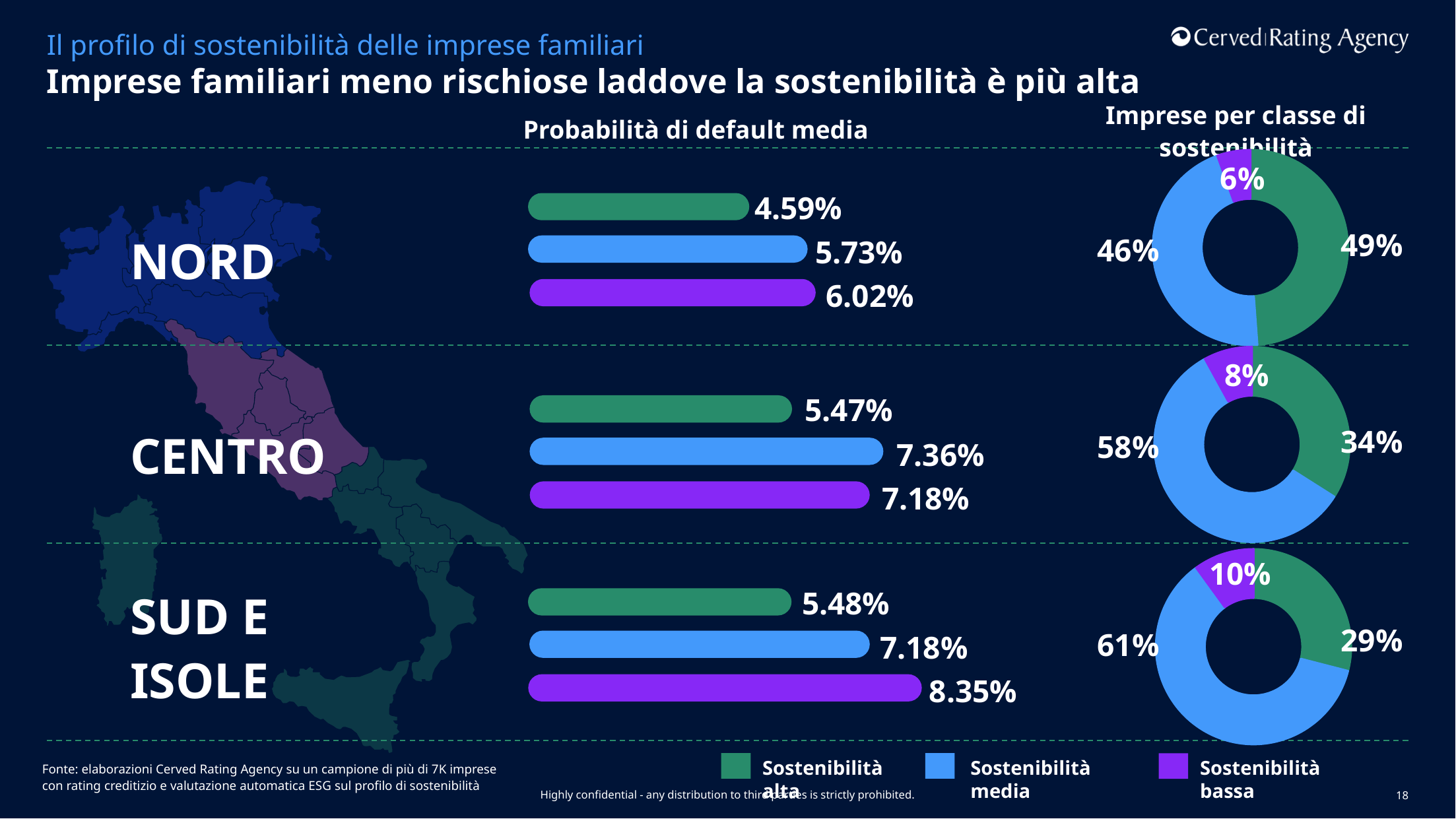
What kind of chart is used for 'Imprese per classe di sostenibilità'? Donut (pie) chart In the 'Probabilità di default media' bar chart, which sustainability class has the highest value in the SUD E ISOLE region? Sostenibilità bassa In the 'Probabilità di default media' bar chart, what is the value for Sostenibilità bassa in the SUD E ISOLE region? 8.35% In the 'Probabilità di default media' bar chart, what is the value for Sostenibilità alta in the NORD region? 4.59% In the 'Probabilità di default media' bar chart, what is the difference between Sostenibilità bassa and Sostenibilità alta in the NORD region? 1.43% In the 'Probabilità di default media' bar chart, which sustainability class has the lowest value in the CENTRO region? Sostenibilità alta In the 'Probabilità di default media' bar chart, what is the value for Sostenibilità media in the CENTRO region? 7.36% How many series does the legend at the bottom of the slide list? 3 In the 'Imprese per classe di sostenibilità' donut chart for NORD, what share of firms has Sostenibilità alta? 49% In the 'Imprese per classe di sostenibilità' donut chart for CENTRO, which sustainability class has the largest share? Sostenibilità media In the 'Imprese per classe di sostenibilità' donut chart for SUD E ISOLE, what share of firms has Sostenibilità bassa? 10% In the 'Probabilità di default media' bar chart, which is larger in the CENTRO region: Sostenibilità media or Sostenibilità bassa? Sostenibilità media